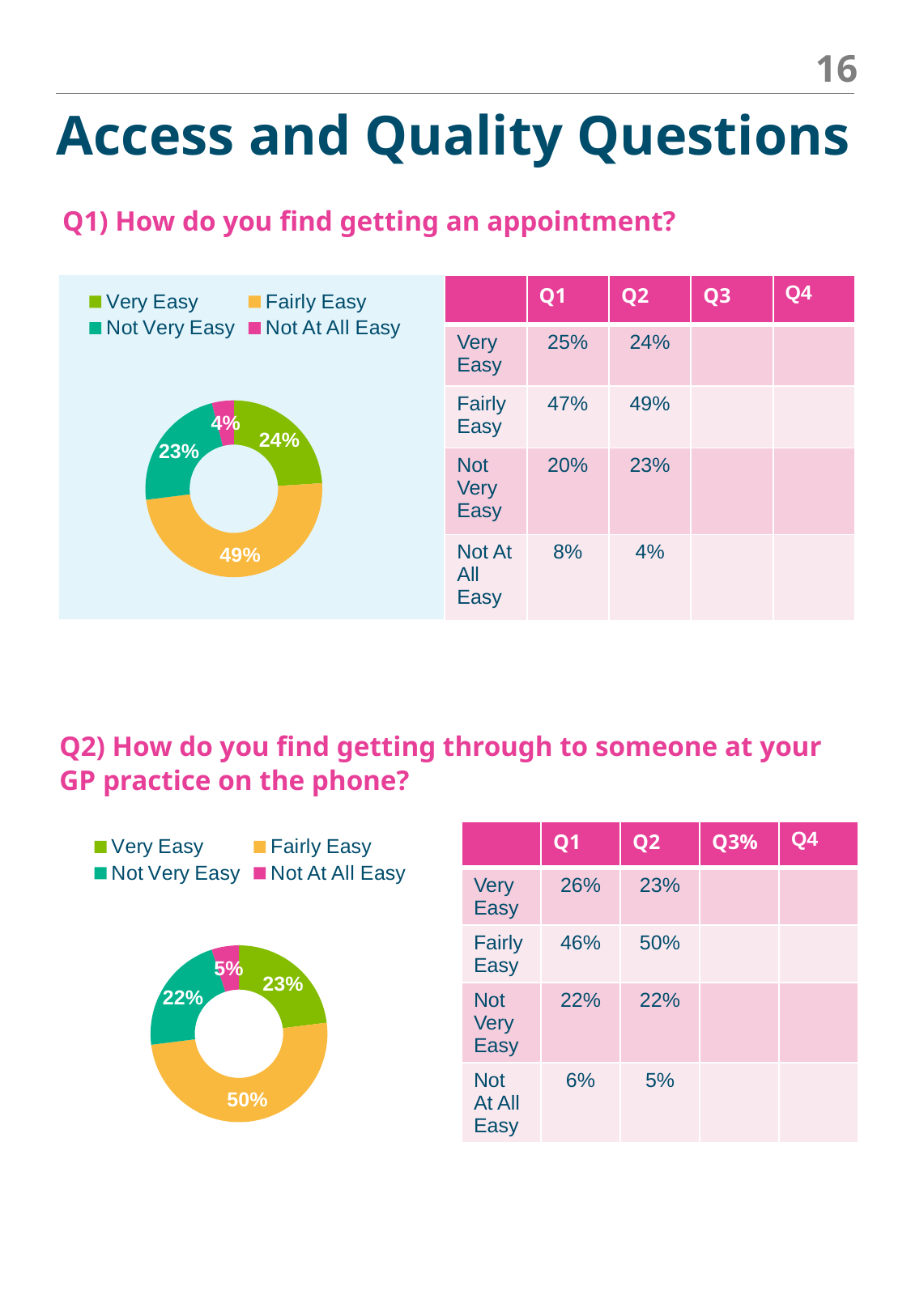
In the bottom chart (Q2, getting through on the phone), which category has the largest share? Fairly Easy In the top chart (Q1, getting an appointment), what percentage is shown for Not At All Easy? 4% In the top chart (Q1, getting an appointment), which category has the largest share? Fairly Easy How many categories does the legend of the top chart (Q1, getting an appointment) list? 4 In the bottom chart (Q2, getting through on the phone), is the share for Fairly Easy larger or smaller than the share for Not At All Easy? larger In the bottom chart (Q2, getting through on the phone), what percentage is shown for Not Very Easy? 22% In the bottom chart (Q2, getting through on the phone), what percentage is shown for Very Easy? 23% What type of chart is used for the bottom chart (Q2, getting through on the phone)? Doughnut (pie) chart In the top chart (Q1, getting an appointment), which category has the smallest share? Not At All Easy In the top chart (Q1, getting an appointment), what percentage is shown for Fairly Easy? 49% In the bottom chart (Q2, getting through on the phone), what is the difference between the Fairly Easy and Very Easy shares? 27% In the top chart (Q1, getting an appointment), what is the difference between the Very Easy and Not Very Easy shares? 1%